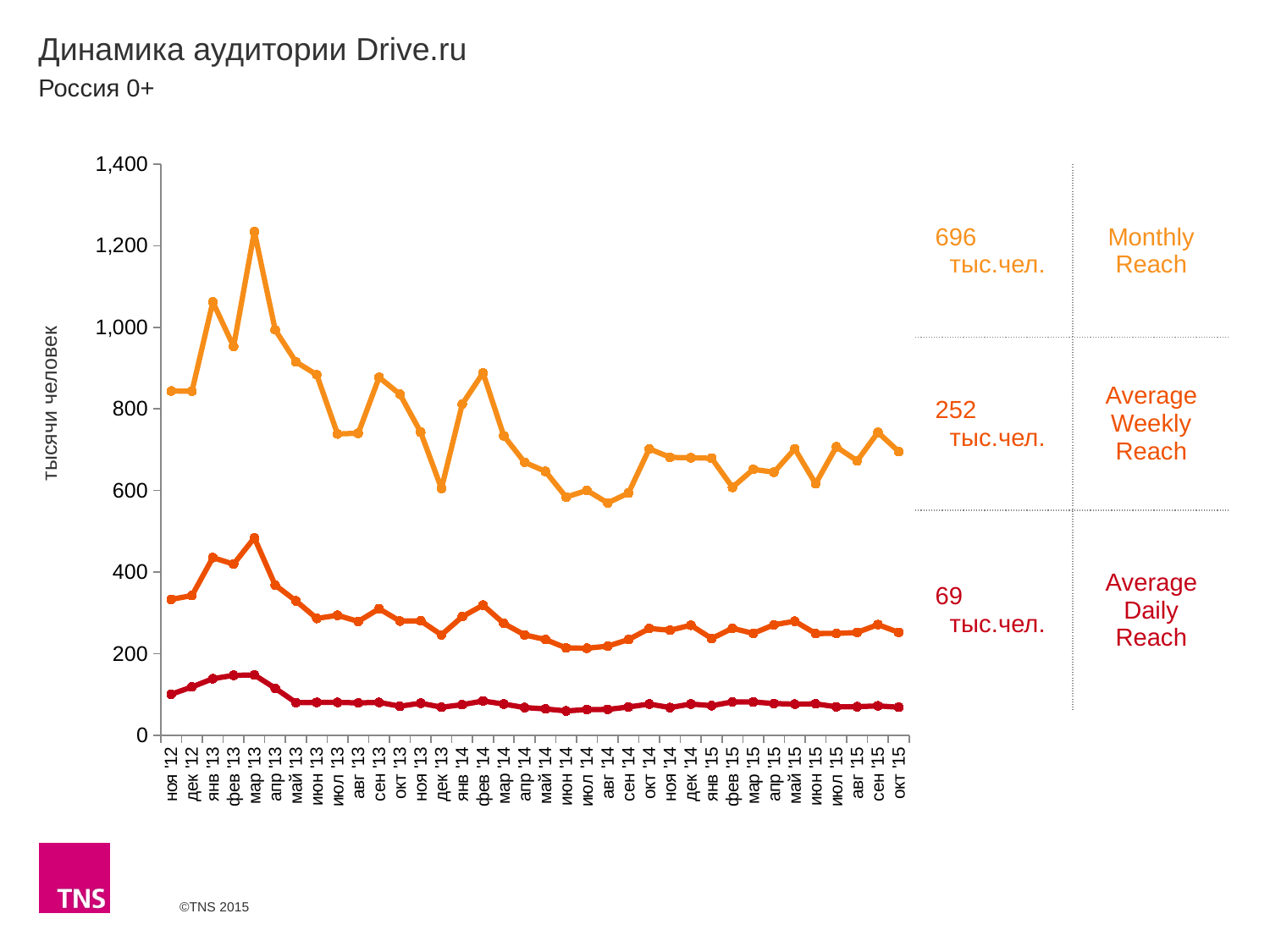
What is the difference between the Monthly Reach and Average Weekly Reach values shown for окт '15? 444 тыс.чел. Which is larger, the Monthly Reach for янв '13 or for фев '13? янв '13 What is the Average Daily Reach value shown for окт '15? 69 тыс.чел. How many monthly data points does each line have, from ноя '12 to окт '15? 36 Is the Monthly Reach value for дек '13 greater or less than 800? less What kind of chart is shown on the slide? line chart In which month does the Monthly Reach line reach its highest point? мар '13 What is the Average Weekly Reach value shown for окт '15? 252 тыс.чел. What is the label on the vertical axis? тысячи человек How many series does the chart show? 3 What is the Monthly Reach value shown for окт '15? 696 тыс.чел. In which month does the Average Weekly Reach line reach its highest point? мар '13